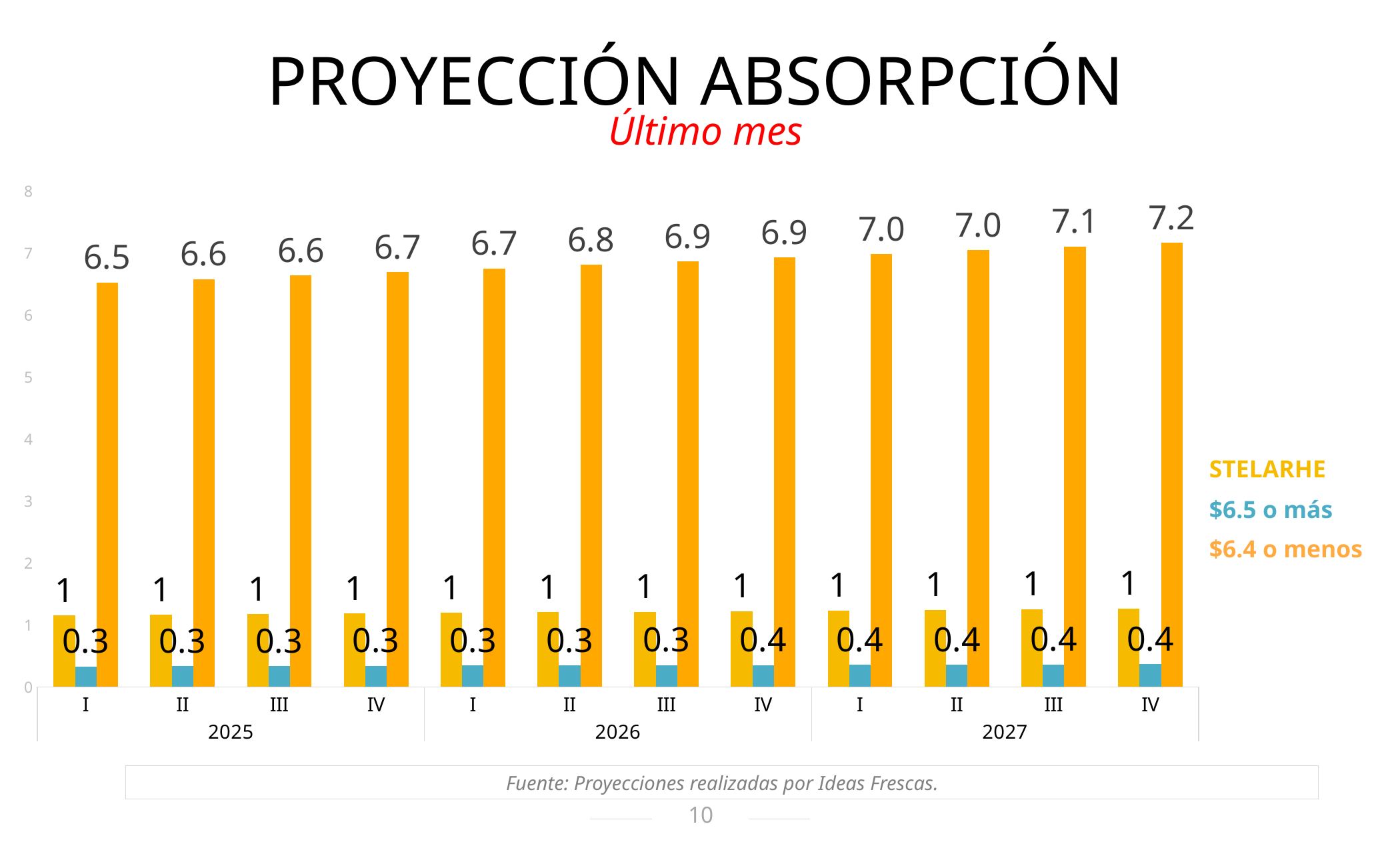
What is the value of the "$6.5 o más" series for quarter II of 2026? 0.3 How many quarters are shown on the x axis? 12 What is the difference between the "$6.4 o menos" values for quarter IV of 2027 and quarter I of 2025? 0.7 Which is larger for quarter II of 2027: the STELARHE value or the "$6.5 o más" value? STELARHE How many series does the legend list? 3 Does the "$6.4 o menos" series rise or fall from 2025 to 2027? Rise What is the value of the "$6.4 o menos" series for quarter I of 2025? 6.5 In which quarter does the "$6.4 o menos" series reach its highest value? IV 2027 Is the "$6.4 o menos" value for quarter I of 2027 greater or less than 6? greater What is the value of the STELARHE series for quarter III of 2027? 1 What is the value of the "$6.4 o menos" series for quarter IV of 2027? 7.2 What kind of chart is shown on the slide? Bar chart